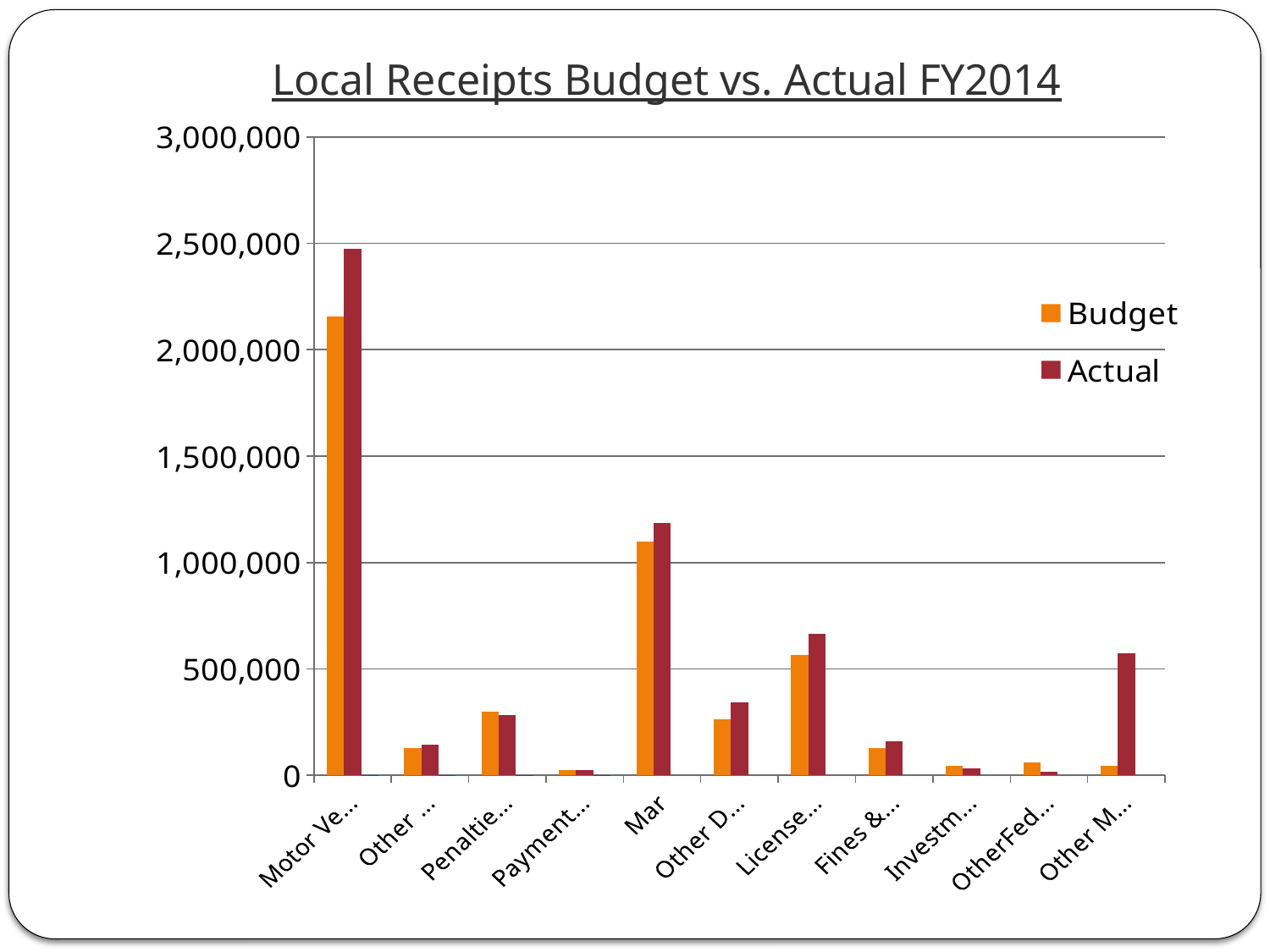
Which series is shown in orange in the legend? Budget Is the Budget value for Other M... greater or less than 500,000? less Is the Actual value for Mar greater or less than 1,000,000? greater What kind of chart is shown on the slide? Bar chart Which category has the highest Budget value? Motor Ve... For OtherFed..., which is larger, the Budget value or the Actual value? Budget Is the Actual value for Motor Ve... greater or less than 2,000,000? greater For Other M..., which is larger, the Budget value or the Actual value? Actual Which category has the highest Actual value? Motor Ve... What is the title of the chart? Local Receipts Budget vs. Actual FY2014 How many series does the legend list? 2 How many categories are shown along the x axis? 11